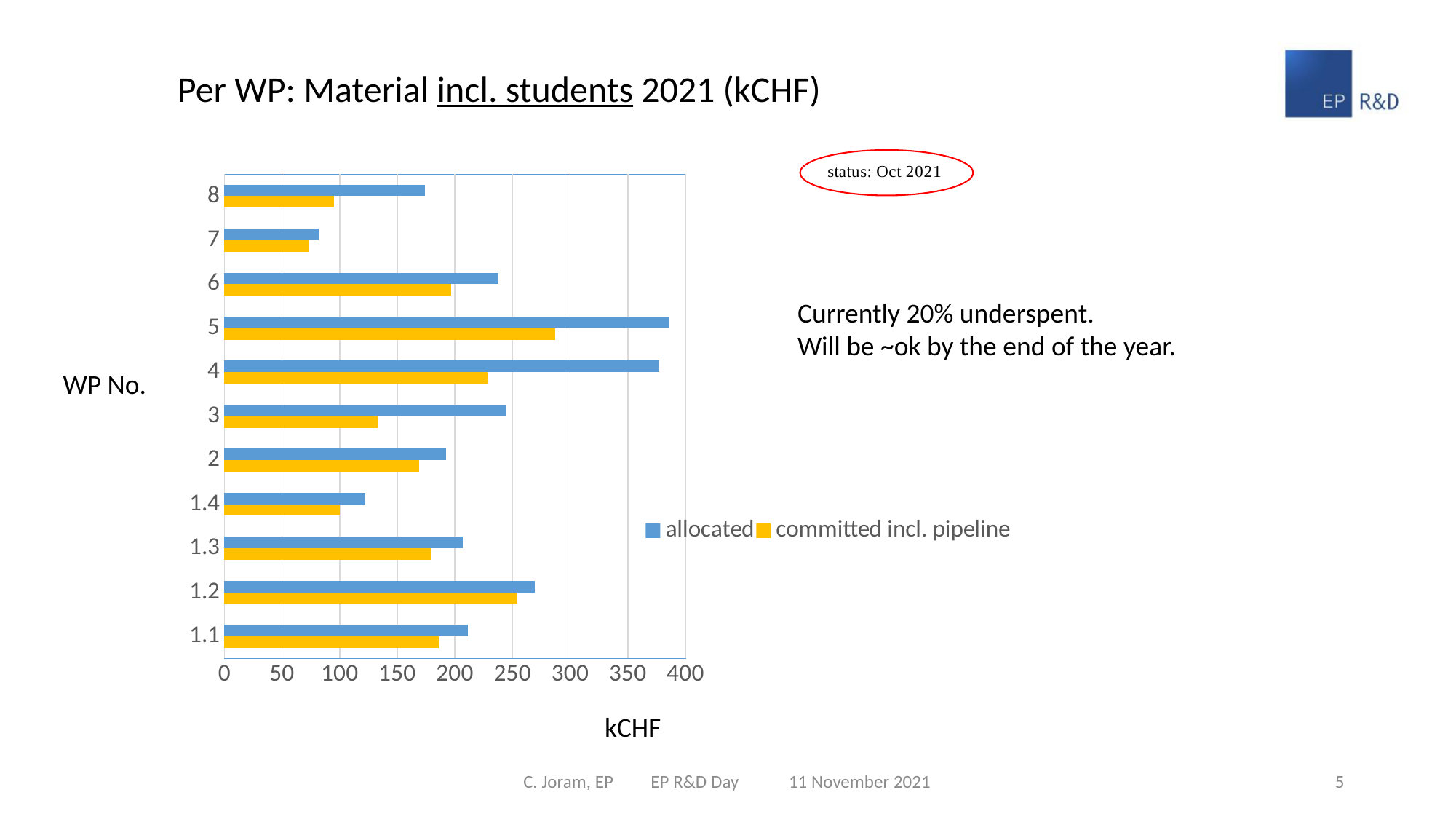
Which WP has the highest committed incl. pipeline value? 5 Which WP has the lowest allocated value? 7 Which WP has the lowest committed incl. pipeline value? 7 Is the allocated value for WP 1.2 greater or less than 250? greater What kind of chart is shown on the slide? bar chart How many WP categories are shown on the y axis of the chart? 11 Is the allocated value for WP 5 greater or less than 350? greater How many series does the chart legend list? 2 Is the committed incl. pipeline value for WP 4 greater or less than 250? less For WP 3, which is larger: the allocated value or the committed incl. pipeline value? allocated What unit is shown on the x axis label of the chart? kCHF